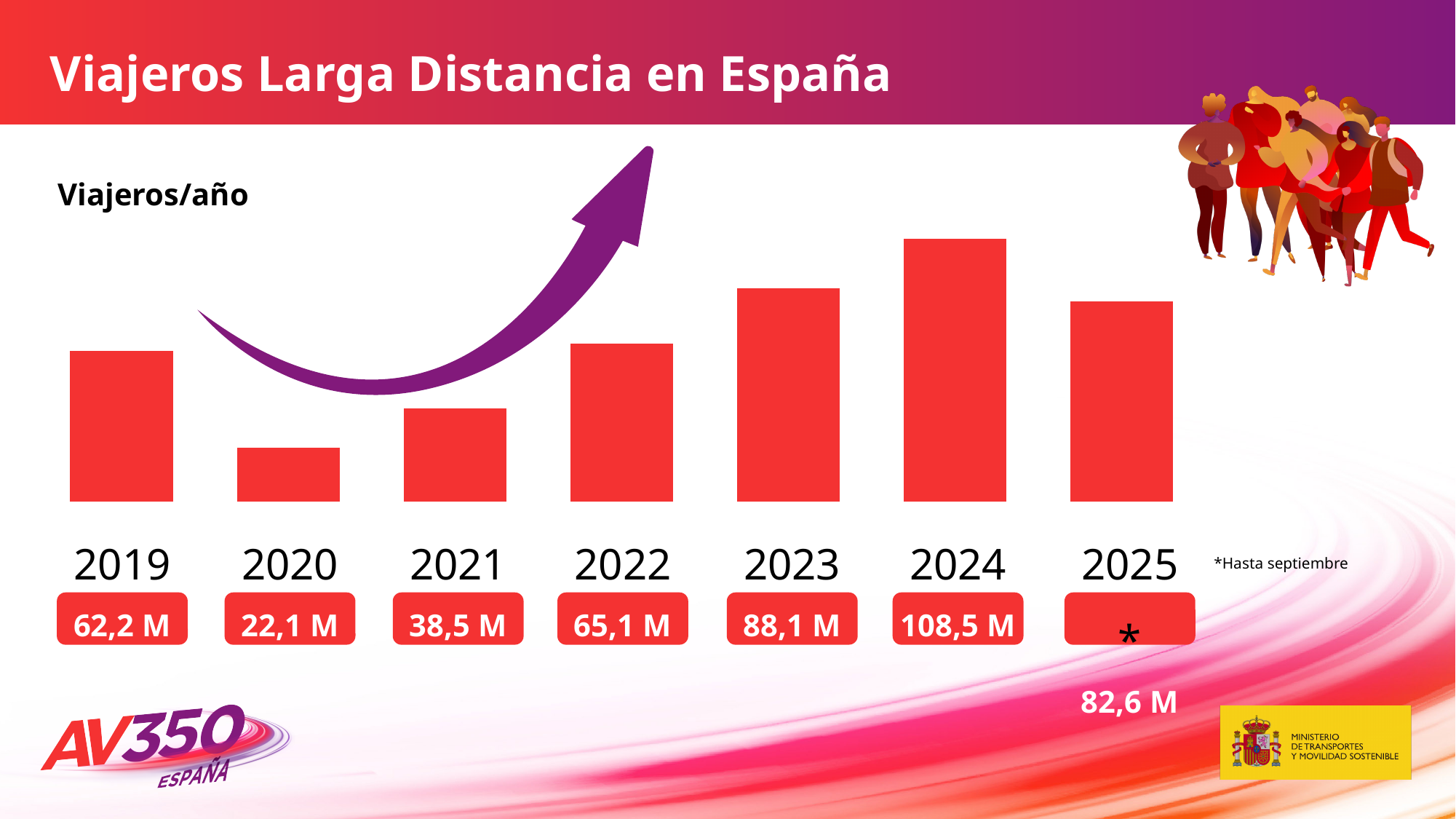
What is the difference between the values for 2019 and 2020? 40,1 M What is the title of the slide? Viajeros Larga Distancia en España What is the value for 2020? 22,1 M Which year has the highest value? 2024 What is the difference between the values for 2024 and 2023? 20,4 M How many years are shown on the chart? 7 What kind of chart is shown on the slide? Bar chart Do the values rise or fall from 2020 to 2024? Rise Which year has the lowest value? 2020 Which is larger, the value for 2019 or the value for 2022? 2022 What is the value for 2024? 108,5 M What is the value shown for 2025 (up to September)? 82,6 M